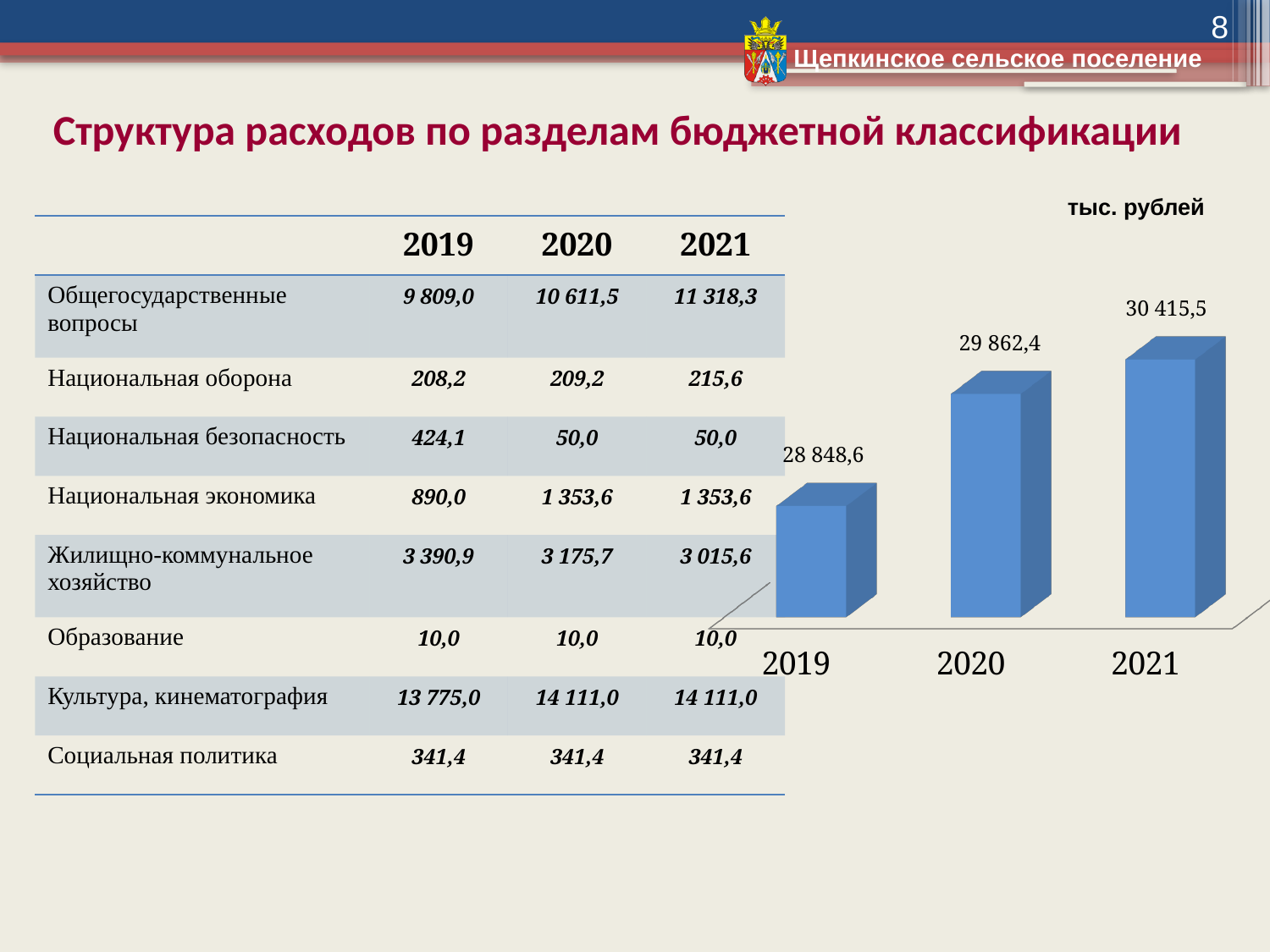
What is the value of the bar for 2019 in the chart? 28 848,6 What is the difference between the 2021 and 2020 values in the chart? 553,1 Which year has the highest bar in the chart? 2021 What is the value of the bar for 2021 in the chart? 30 415,5 What is the difference between the 2021 and 2019 values in the chart? 1 566,9 By how much does the 2020 value exceed the 2019 value in the chart? 1 013,8 Which year has the lowest bar in the chart? 2019 What type of chart is shown on the slide? Bar chart How many bars are shown in the chart? 3 Which is larger in the chart, the value for 2020 or the value for 2021? 2021 What is the value of the bar for 2020 in the chart? 29 862,4 Do the values in the chart rise or fall from 2019 to 2021? Rise